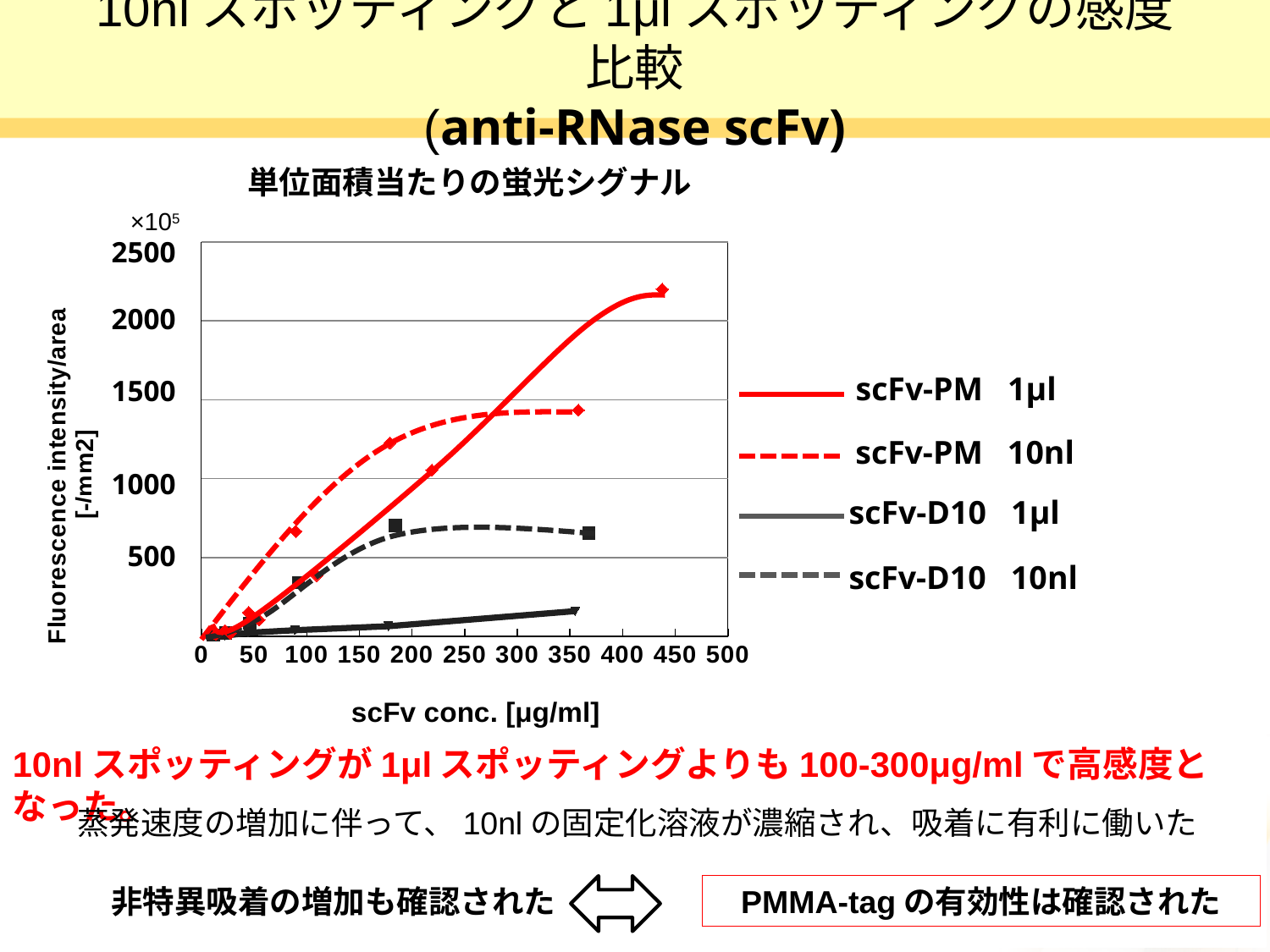
Is the value of the scFv-D10 1μl series at around 350 μg/ml greater or less than 500? less What kind of chart is shown on the slide? line chart Is the value of the scFv-PM 10nl series at its last point (around 360 μg/ml) greater or less than 1500? less At 100 μg/ml, which series has the larger value: scFv-PM 10nl or scFv-PM 1μl? scFv-PM 10nl Which series stays lowest across the whole concentration range? scFv-D10 1μl How many series does the legend list? 4 Is the value of the scFv-PM 10nl series at its last point (around 360 μg/ml) greater or less than 1000? greater Which series is drawn as a solid red line? scFv-PM 1μl Which series reaches the highest fluorescence intensity on the chart? scFv-PM 1μl What is the label of the x axis? scFv conc. [μg/ml]